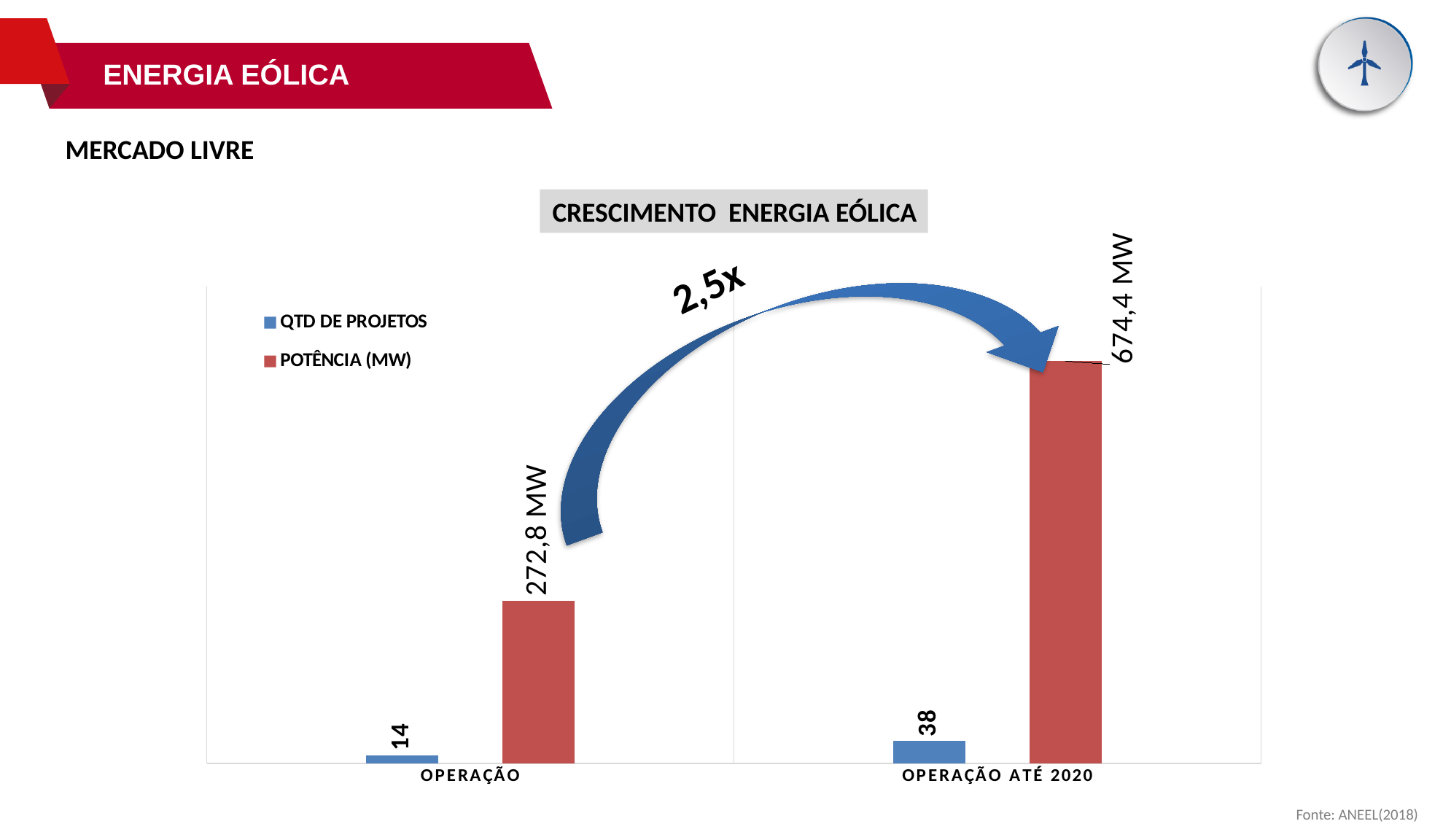
What is the difference in QTD DE PROJETOS between OPERAÇÃO ATÉ 2020 and OPERAÇÃO? 24 What is the value of POTÊNCIA (MW) for OPERAÇÃO? 272,8 MW What is the value of QTD DE PROJETOS for OPERAÇÃO ATÉ 2020? 38 Which category has the higher POTÊNCIA (MW) value? OPERAÇÃO ATÉ 2020 How many series does the legend list? 2 What type of chart is shown on the slide? bar chart What is the value of QTD DE PROJETOS for OPERAÇÃO? 14 What is the value of POTÊNCIA (MW) for OPERAÇÃO ATÉ 2020? 674,4 MW How many categories are shown on the x axis of the chart? 2 What is the difference in POTÊNCIA (MW) between OPERAÇÃO ATÉ 2020 and OPERAÇÃO? 401,6 MW Is the POTÊNCIA (MW) value for OPERAÇÃO larger or smaller than the value for OPERAÇÃO ATÉ 2020? smaller Which category has the lower QTD DE PROJETOS value? OPERAÇÃO